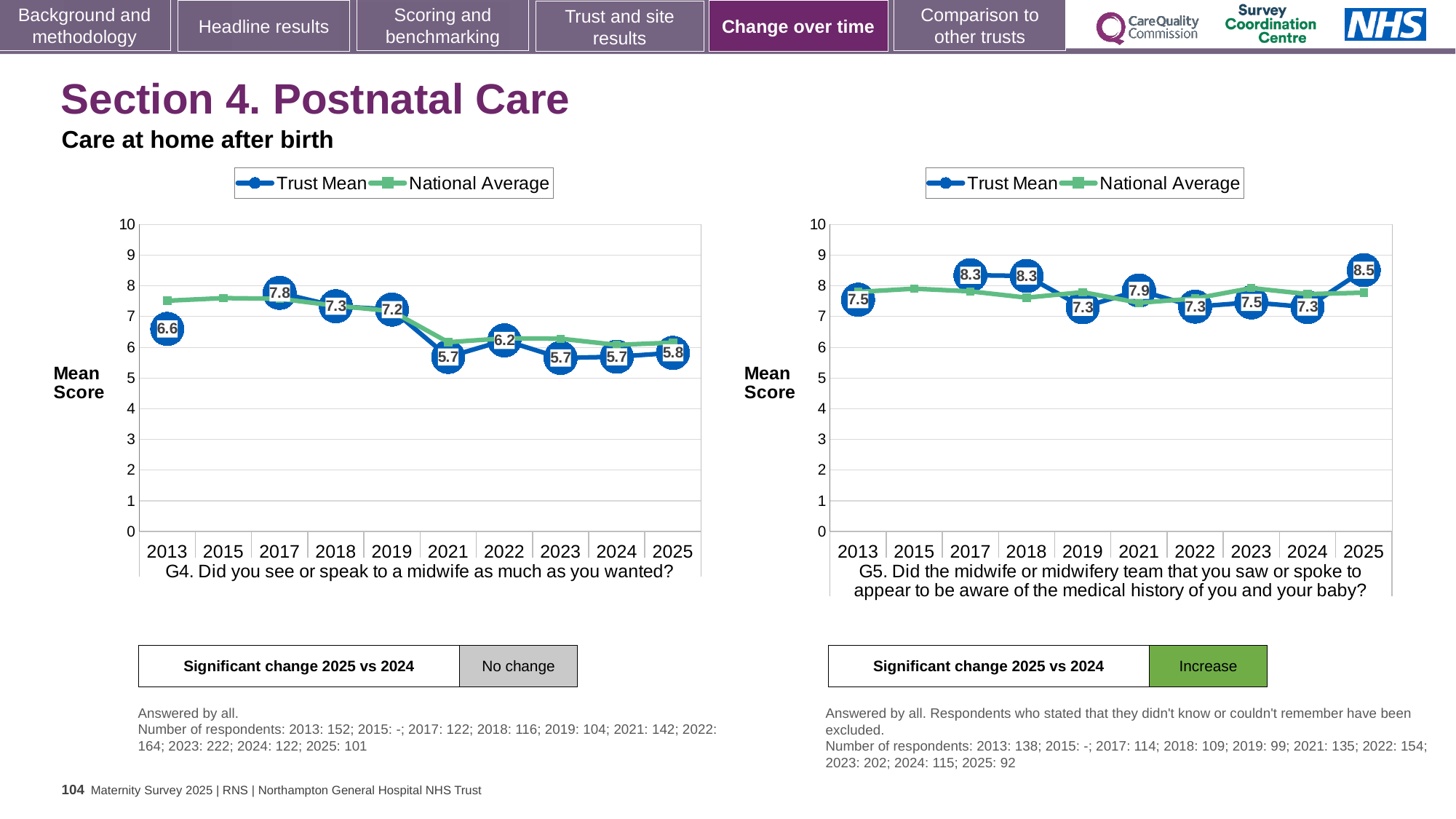
What kind of chart is the G4 chart (left)? Line chart How many series does the legend of the G5 chart (right) list? 2 In the G5 chart (right), what is the difference between the Trust Mean in 2025 and in 2024? 1.2 In the G4 chart (left), is the National Average for 2025 greater or less than 7? less In the G4 chart (left), what is the difference between the Trust Mean in 2017 and in 2025? 2.0 In the G5 chart (right), what is the Trust Mean for 2025? 8.5 In the G4 chart (left), what is the Trust Mean for 2025? 5.8 How many years are shown on the x axis of the G4 chart (left)? 10 In the G5 chart (right), is the Trust Mean for 2021 larger or smaller than the Trust Mean for 2022? larger In the G4 chart (left), which year has the highest Trust Mean? 2017 In the G5 chart (right), which year has the highest Trust Mean? 2025 In the G4 chart (left), what is the Trust Mean for 2013? 6.6